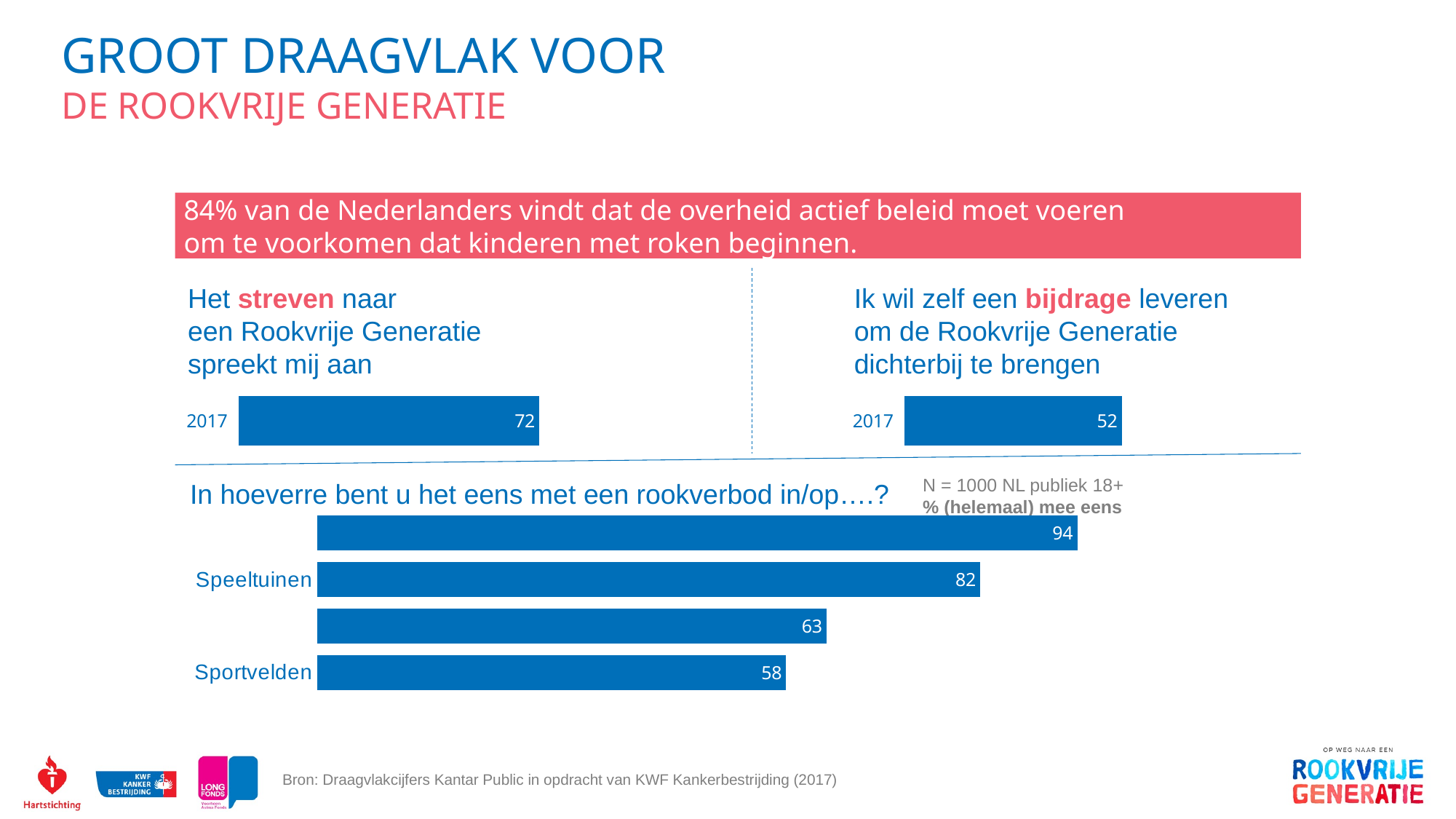
In the chart under 'Ik wil zelf een bijdrage leveren om de Rookvrije Generatie dichterbij te brengen', what is the value for 2017? 52 In the chart under 'Het streven naar een Rookvrije Generatie spreekt mij aan', what is the value for 2017? 72 How many bars are in the bottom chart 'In hoeverre bent u het eens met een rookverbod in/op….?'? 4 In the bottom chart 'In hoeverre bent u het eens met een rookverbod in/op….?', what is the value for Speeltuinen? 82 In the bottom chart 'In hoeverre bent u het eens met een rookverbod in/op….?', what is the highest value shown on any bar? 94 Which is larger: the 2017 value for 'Het streven naar een Rookvrije Generatie spreekt mij aan' or the 2017 value for 'Ik wil zelf een bijdrage leveren'? Het streven naar een Rookvrije Generatie spreekt mij aan In the bottom chart 'In hoeverre bent u het eens met een rookverbod in/op….?', which has the larger value: Speeltuinen or Sportvelden? Speeltuinen What kind of chart is the bottom chart 'In hoeverre bent u het eens met een rookverbod in/op….?'? Bar chart In the bottom chart 'In hoeverre bent u het eens met een rookverbod in/op….?', what is the value for Sportvelden? 58 What is the difference between the 2017 value for 'Het streven naar een Rookvrije Generatie spreekt mij aan' and the 2017 value for 'Ik wil zelf een bijdrage leveren'? 20 In the bottom chart 'In hoeverre bent u het eens met een rookverbod in/op….?', what is the difference between the values for Speeltuinen and Sportvelden? 24 In the bottom chart 'In hoeverre bent u het eens met een rookverbod in/op….?', which labelled category has the lowest value? Sportvelden